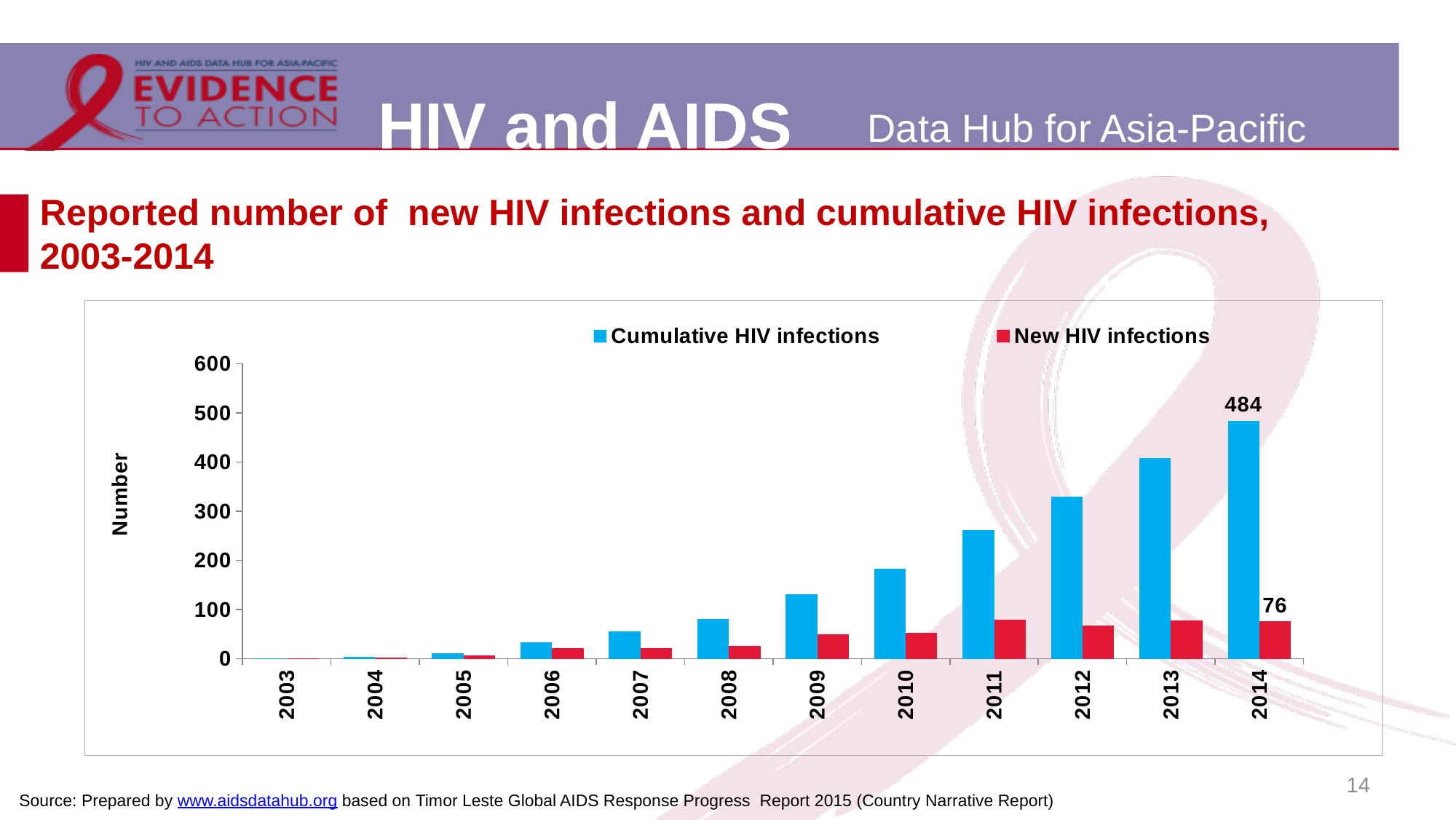
Is the value for Cumulative HIV infections in 2012 greater or less than 300? greater How many years are shown on the x axis of the chart? 12 What is the value for Cumulative HIV infections in 2014? 484 What is the value for New HIV infections in 2014? 76 Is the value for Cumulative HIV infections in 2009 greater or less than 100? greater Is the value for New HIV infections in 2011 greater or less than 100? less What kind of chart is shown on the slide? bar chart How many series does the legend list? 2 Which is larger: Cumulative HIV infections in 2012 or in 2013? 2013 In which year is the Cumulative HIV infections bar the highest? 2014 Do the Cumulative HIV infections values rise or fall from 2003 to 2014? rise What is the difference between Cumulative HIV infections and New HIV infections in 2014? 408